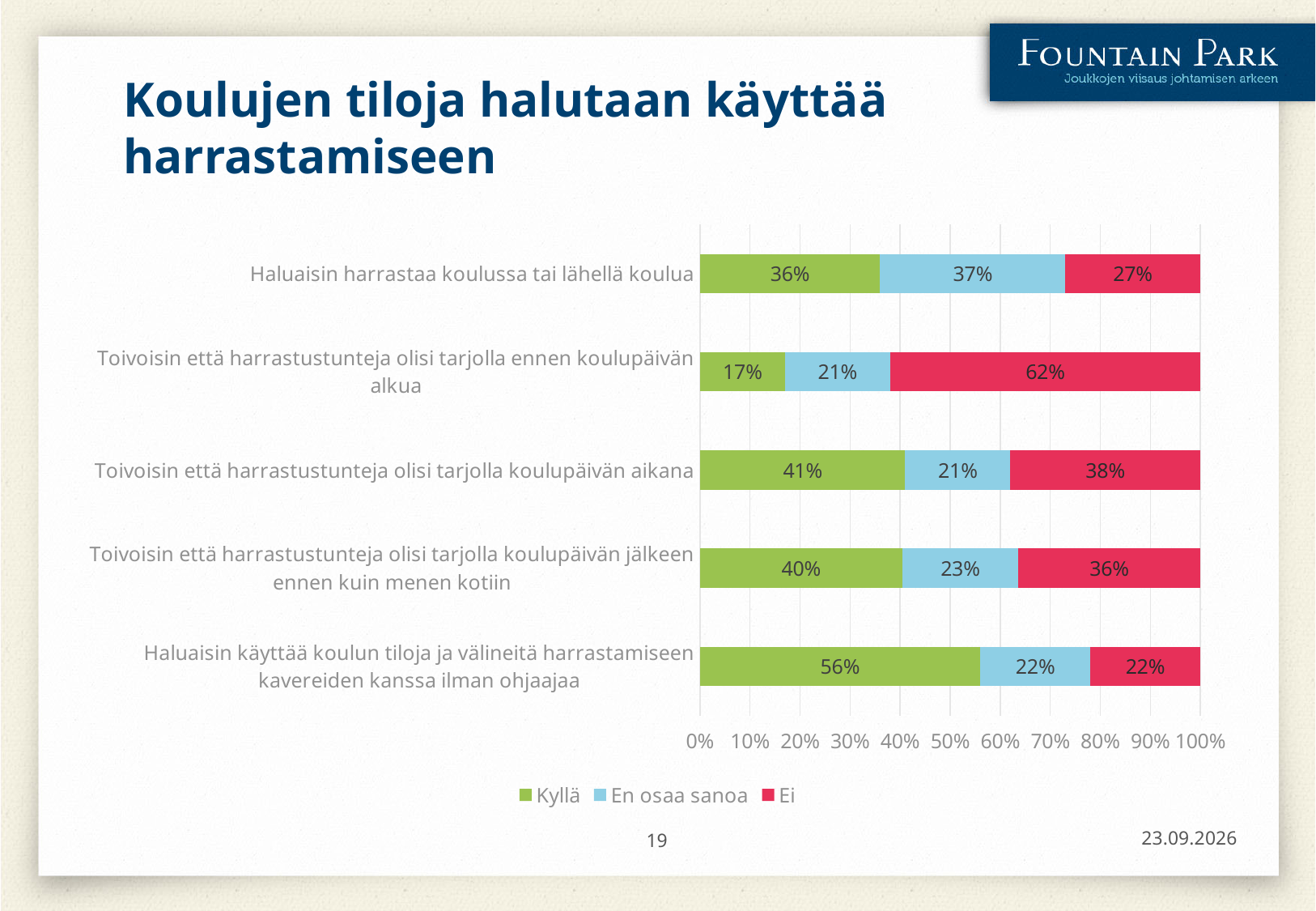
Which category has the highest "Kyllä" value? Haluaisin käyttää koulun tiloja ja välineitä harrastamiseen kavereiden kanssa ilman ohjaajaa What is the total of the stacked bar for "Haluaisin käyttää koulun tiloja ja välineitä harrastamiseen kavereiden kanssa ilman ohjaajaa"? 100% How many categories are shown in the chart? 5 What is the "En osaa sanoa" value for "Toivoisin että harrastustunteja olisi tarjolla koulupäivän jälkeen ennen kuin menen kotiin"? 23% What is the difference between the "Ei" value for "Toivoisin että harrastustunteja olisi tarjolla ennen koulupäivän alkua" and the "Ei" value for "Haluaisin harrastaa koulussa tai lähellä koulua"? 35% Which colour represents the "Ei" series in the chart? Red Which category has the lowest "Kyllä" value? Toivoisin että harrastustunteja olisi tarjolla ennen koulupäivän alkua What is the "Kyllä" value for "Haluaisin harrastaa koulussa tai lähellä koulua"? 36% What is the "Ei" value for "Toivoisin että harrastustunteja olisi tarjolla ennen koulupäivän alkua"? 62% What kind of chart is shown on the slide? Stacked bar chart How many series does the legend list? 3 Which is larger: the "Kyllä" value for "Toivoisin että harrastustunteja olisi tarjolla koulupäivän aikana" or the "Ei" value for the same category? Kyllä